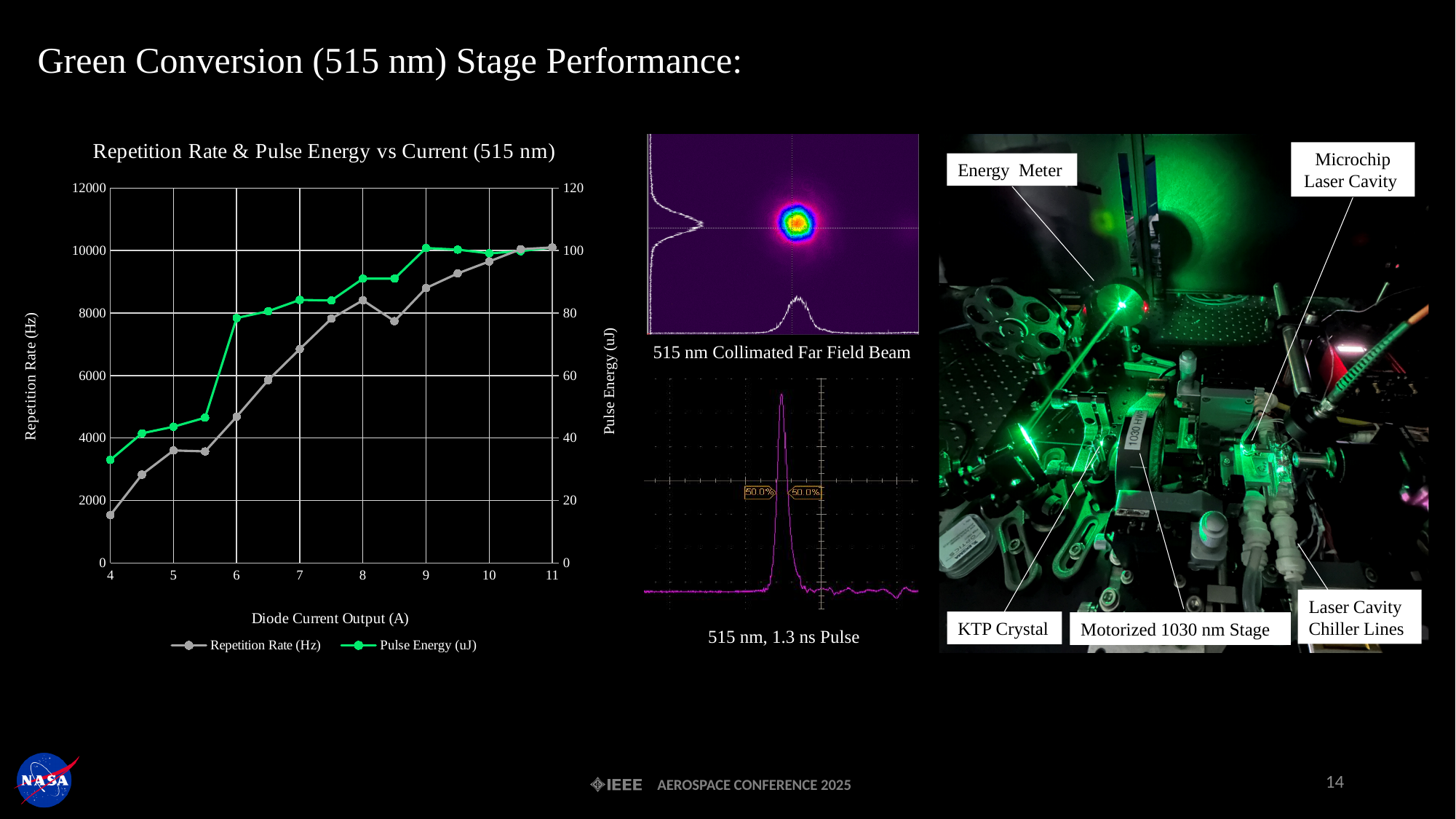
What kind of chart is shown on the slide? line chart How many data points are plotted for the Repetition Rate (Hz) series? 15 Does the Repetition Rate (Hz) generally rise or fall as the diode current increases from 4 A to 11 A? rise Is the Repetition Rate (Hz) at 8 A greater or less than 8000? greater Is the Repetition Rate (Hz) at 4 A greater or less than 2000? less Is the Pulse Energy (uJ) at 8 A greater or less than 80? greater How many series does the chart's legend list? 2 What is the label of the chart's x axis? Diode Current Output (A) At which diode current is the Pulse Energy (uJ) lowest? 4 At which diode current is the Repetition Rate (Hz) lowest? 4 Which is larger, the Repetition Rate (Hz) at 8 A or at 8.5 A? 8 A What is the title of the chart on the slide? Repetition Rate & Pulse Energy vs Current (515 nm)